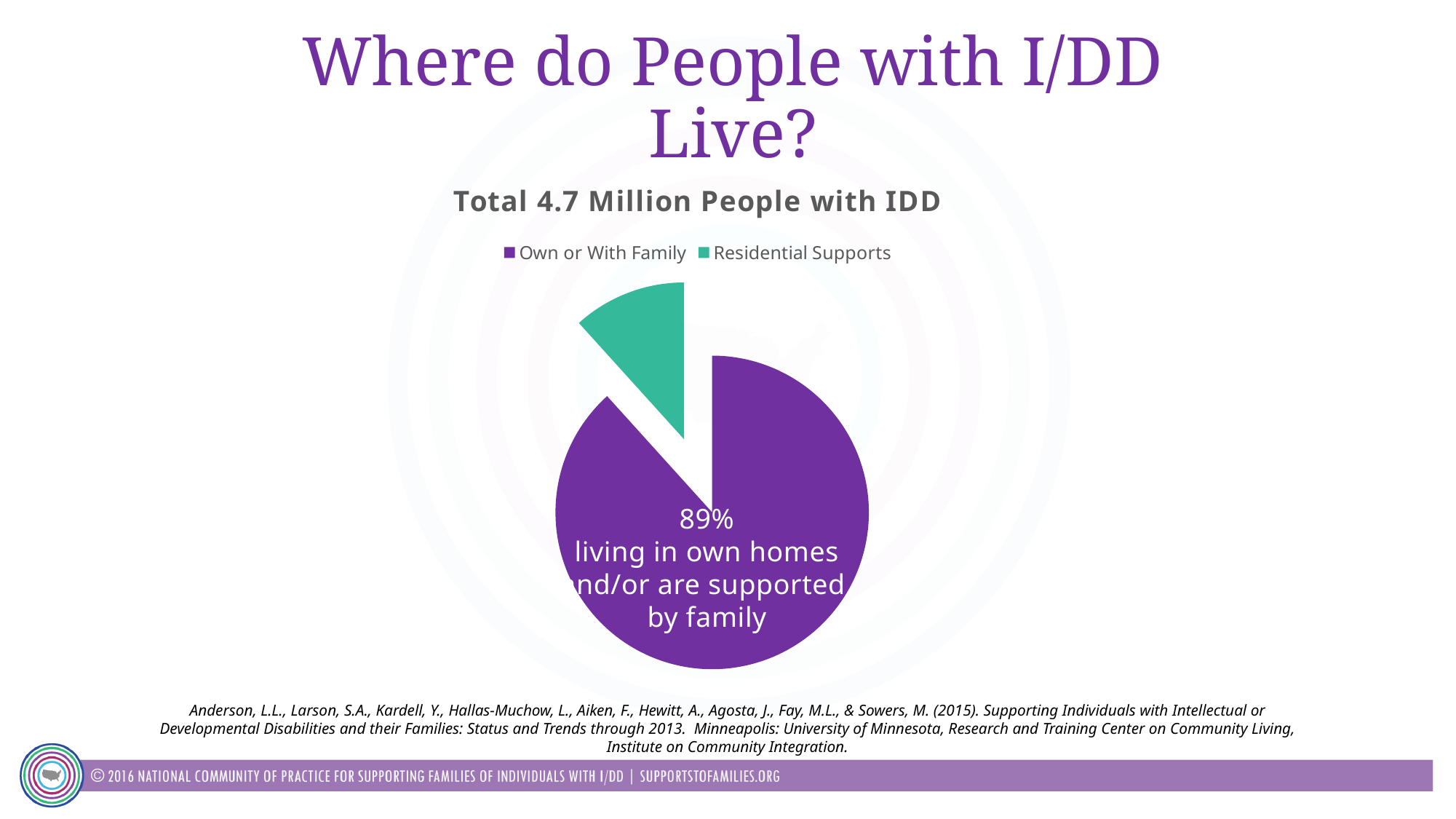
Which slice of the pie chart is the largest? Own or With Family Is the share for 'Residential Supports' greater or less than 50%? less What percentage of the pie is the 'Own or With Family' slice? 89% What colour is the 'Residential Supports' slice in the pie chart? green Which slice of the pie chart is the smallest? Residential Supports What is the title of the pie chart? Total 4.7 Million People with IDD What kind of chart is shown on the slide? pie chart How many entries does the legend of the pie chart list? 2 Is the share for 'Own or With Family' greater or less than 50%? greater How many slices does the pie chart have? 2 Which is larger: the 'Own or With Family' slice or the 'Residential Supports' slice? Own or With Family